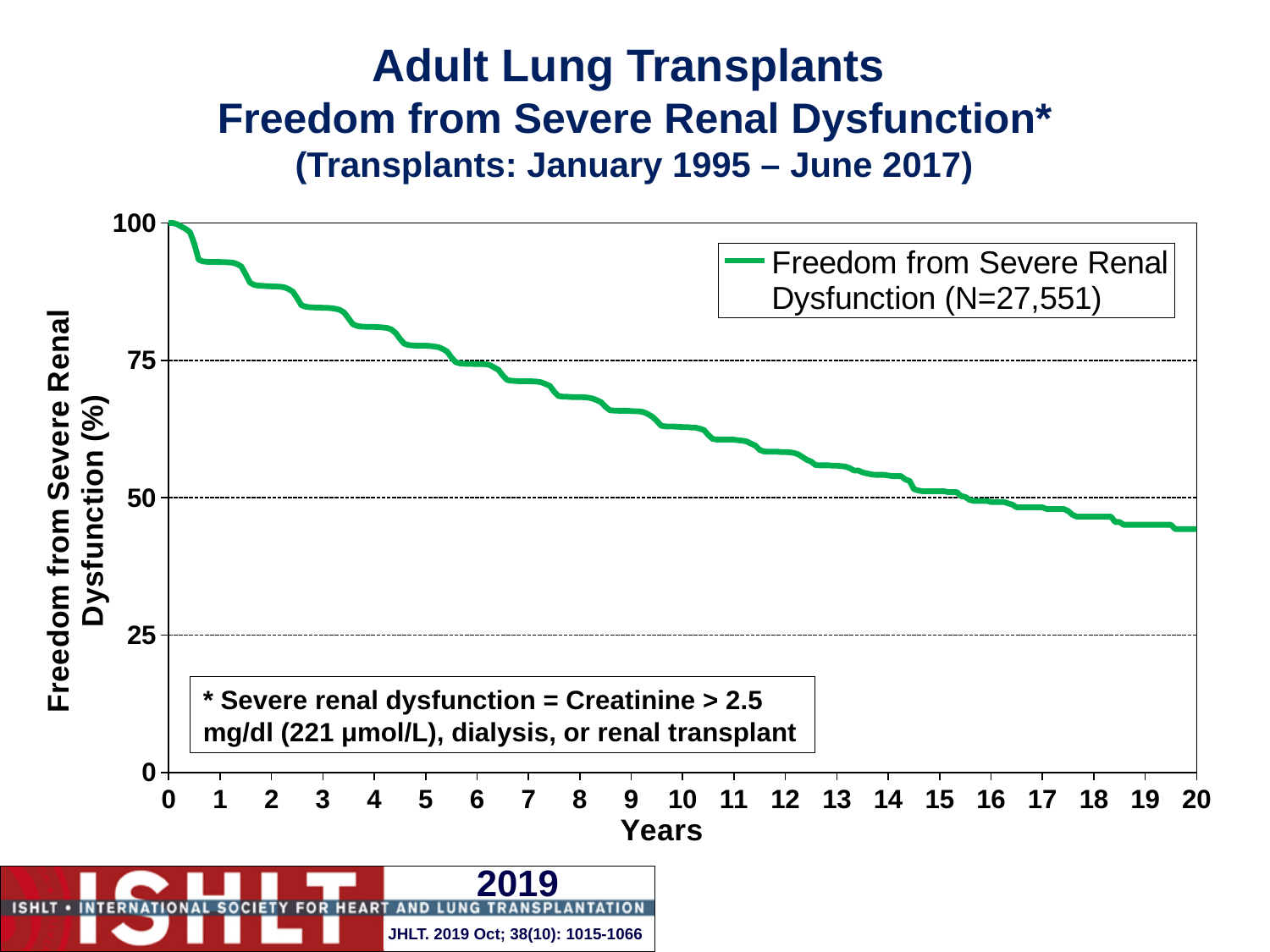
What kind of chart is shown on the slide? Line chart Is the value at year 1 larger or smaller than the value at year 15? Larger What is the N given in the legend for the Freedom from Severe Renal Dysfunction series? N=27,551 Is the value for freedom from severe renal dysfunction at year 8 greater or less than 75? less Is the value for freedom from severe renal dysfunction at year 18 greater or less than 50? less What is the value of freedom from severe renal dysfunction at year 0? 100 What is the label of the x axis? Years How many series does the legend list? 1 Does freedom from severe renal dysfunction rise or fall as the years increase? Fall Is the value for freedom from severe renal dysfunction at year 10 greater or less than 50? greater